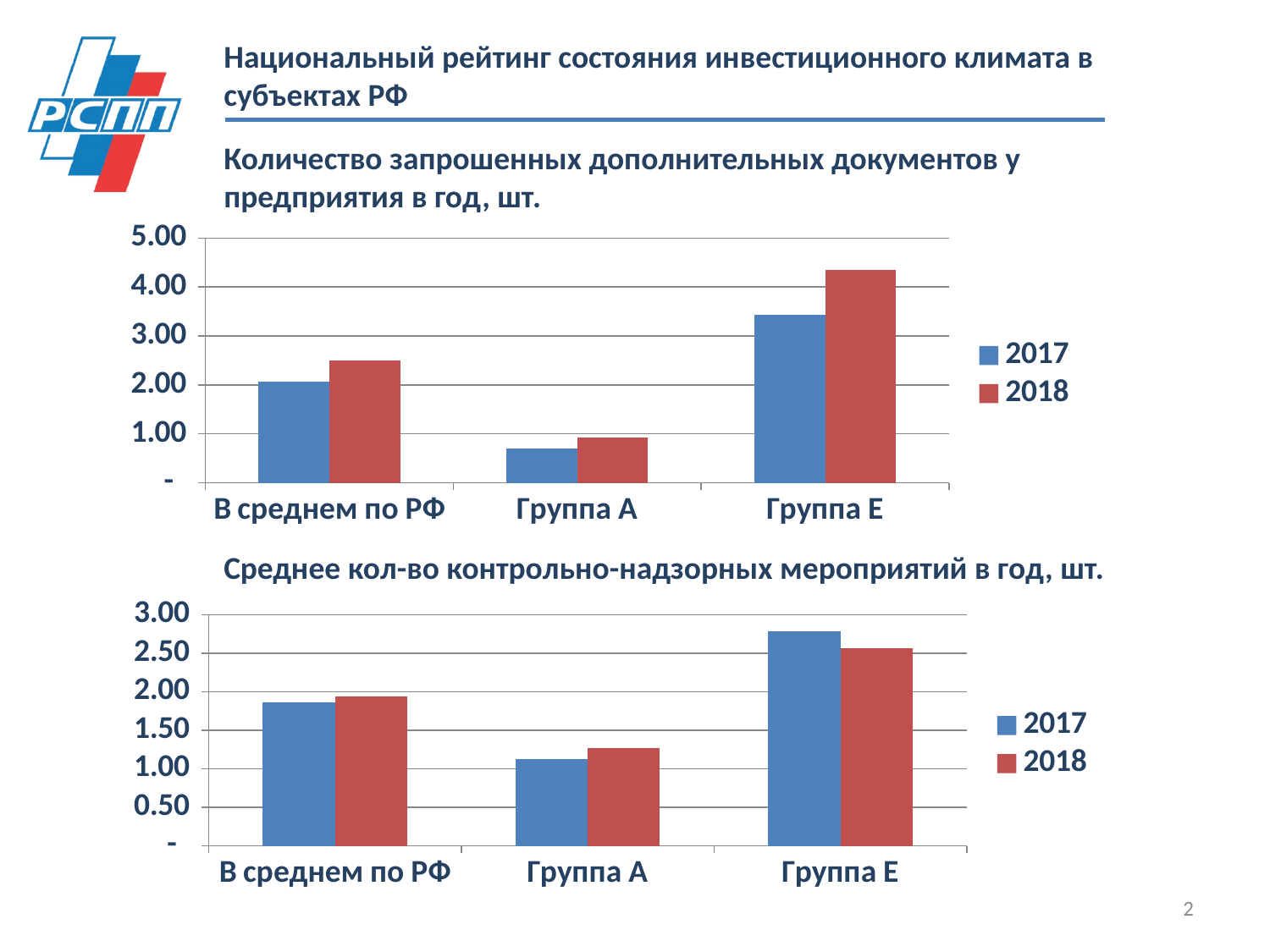
What kind of chart is the top chart, 'Количество запрошенных дополнительных документов у предприятия в год, шт.'? bar chart In the top chart 'Количество запрошенных дополнительных документов', how many series does the legend list? 2 In the top chart 'Количество запрошенных дополнительных документов', which category has the highest value for 2018? Группа Е In the top chart 'Количество запрошенных дополнительных документов', for 'В среднем по РФ', which year has the larger value, 2017 or 2018? 2018 In the bottom chart 'Среднее кол-во контрольно-надзорных мероприятий', for Группа Е, which year has the larger value, 2017 or 2018? 2017 In the bottom chart 'Среднее кол-во контрольно-надзорных мероприятий в год, шт.', how many categories are shown on the x axis? 3 In the bottom chart 'Среднее кол-во контрольно-надзорных мероприятий', what are the two legend entries? 2017 and 2018 In the bottom chart 'Среднее кол-во контрольно-надзорных мероприятий', is the 2017 value for Группа Е greater or less than 2.50? greater In the top chart 'Количество запрошенных дополнительных документов', is the 2018 value for Группа Е greater or less than 4.00? greater In the top chart 'Количество запрошенных дополнительных документов', is the 2017 value for Группа А greater or less than 1.00? less In the bottom chart 'Среднее кол-во контрольно-надзорных мероприятий', which category has the lowest value for 2018? Группа А In the top chart 'Количество запрошенных дополнительных документов', which category has the lowest value for 2017? Группа А